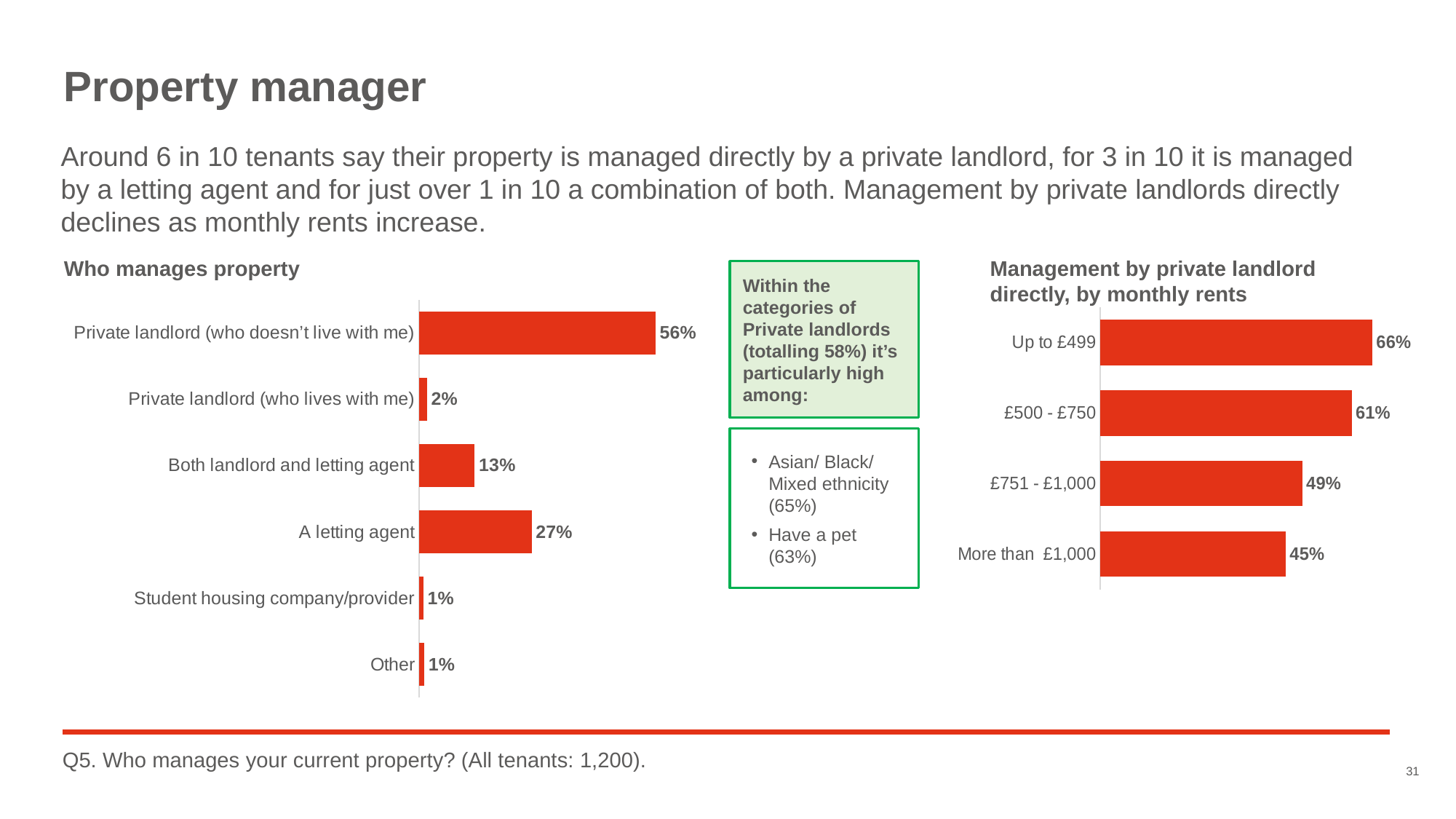
In the 'Management by private landlord directly, by monthly rents' chart, what is the value for '£751 - £1,000'? 49% In the 'Management by private landlord directly, by monthly rents' chart, which rent band has the lowest value? More than £1,000 In the 'Who manages property' chart, which category has the highest value? Private landlord (who doesn't live with me) In the 'Who manages property' chart, which is larger: 'Private landlord (who lives with me)' or 'Both landlord and letting agent'? Both landlord and letting agent What type of chart is the 'Management by private landlord directly, by monthly rents' chart? bar chart In the 'Management by private landlord directly, by monthly rents' chart, do the values rise or fall as monthly rent increases? fall In the 'Who manages property' chart, what is the difference between 'Private landlord (who doesn't live with me)' and 'A letting agent'? 29% In the 'Who manages property' chart, what is the value for 'Both landlord and letting agent'? 13% In the 'Management by private landlord directly, by monthly rents' chart, how many rent bands are shown? 4 In the 'Who manages property' chart, what is the value for 'A letting agent'? 27% In the 'Management by private landlord directly, by monthly rents' chart, what is the difference between 'Up to £499' and 'More than £1,000'? 21% In the 'Who manages property' chart, how many categories are shown? 6